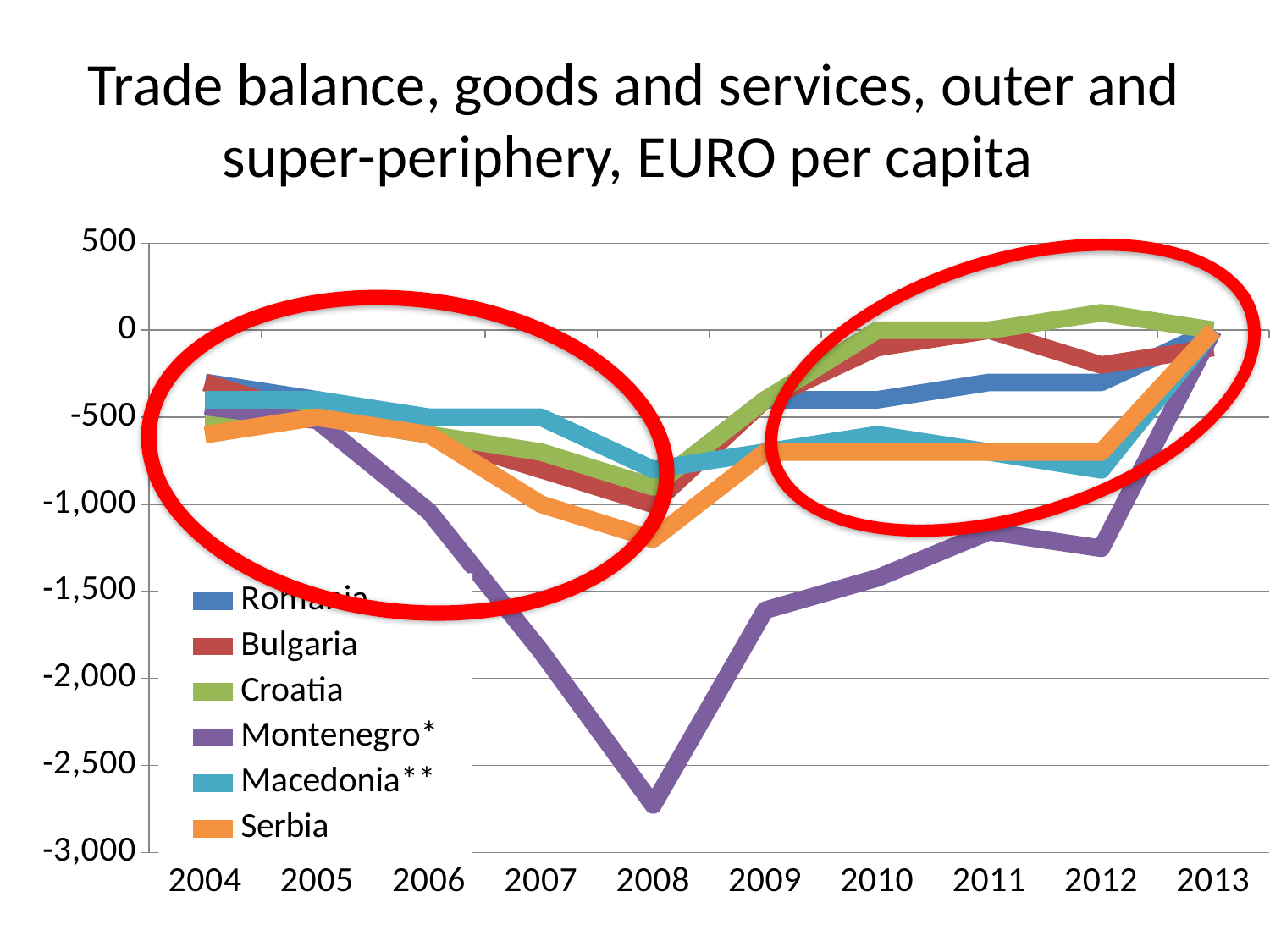
Is the value for Serbia in 2008 greater or less than -1,000? less In 2008, which is larger, the value for Romania or the value for Montenegro*? Romania Which country has the lowest trade balance per capita in 2008? Montenegro* How many years are shown along the x axis? 10 Which country has the highest trade balance per capita in 2012? Croatia What is the title of the chart? Trade balance, goods and services, outer and super-periphery, EURO per capita How many series does the legend list? 6 Does the value for Montenegro* rise or fall from 2008 to 2013? rise Is the value for Montenegro* in 2008 greater or less than -2,500? less Is the value for Croatia in 2012 greater or less than 0? greater What kind of chart is shown on the slide? line chart